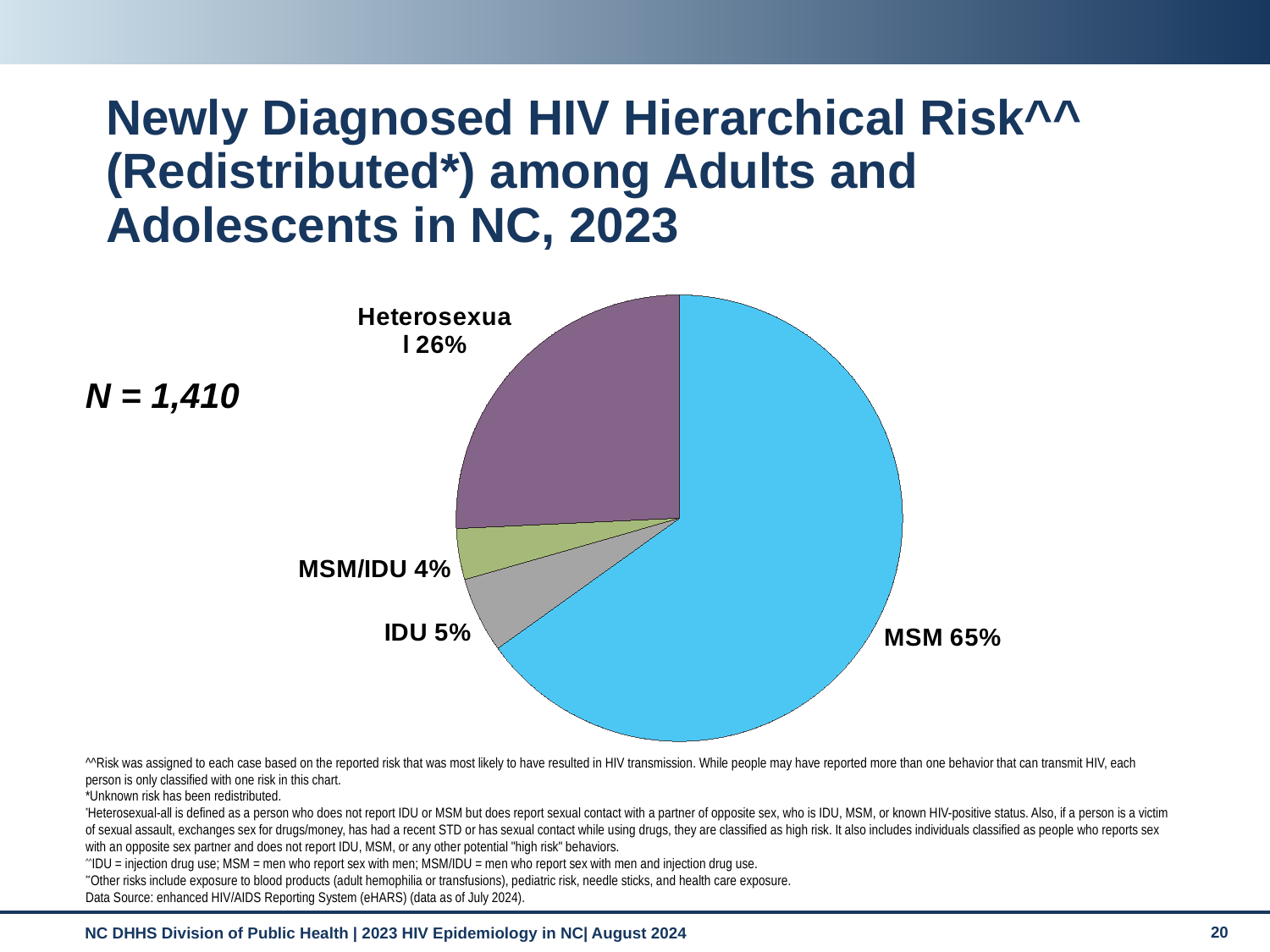
Which is larger, the IDU slice or the MSM/IDU slice? IDU What colour is the MSM slice of the pie chart? light blue What percentage of newly diagnosed HIV cases is attributed to MSM/IDU? 4% What percentage of newly diagnosed HIV cases is attributed to IDU? 5% What type of chart is shown on the slide? pie chart What percentage of newly diagnosed HIV cases is attributed to Heterosexual risk? 26% Which risk category has the largest share of the pie? MSM Which risk category has the smallest share of the pie? MSM/IDU What percentage of newly diagnosed HIV cases is attributed to MSM? 65% How many risk categories are shown in the pie chart? 4 What is the difference in percentage points between the MSM and Heterosexual slices? 39 What is the total N shown on the slide for the pie chart? 1,410